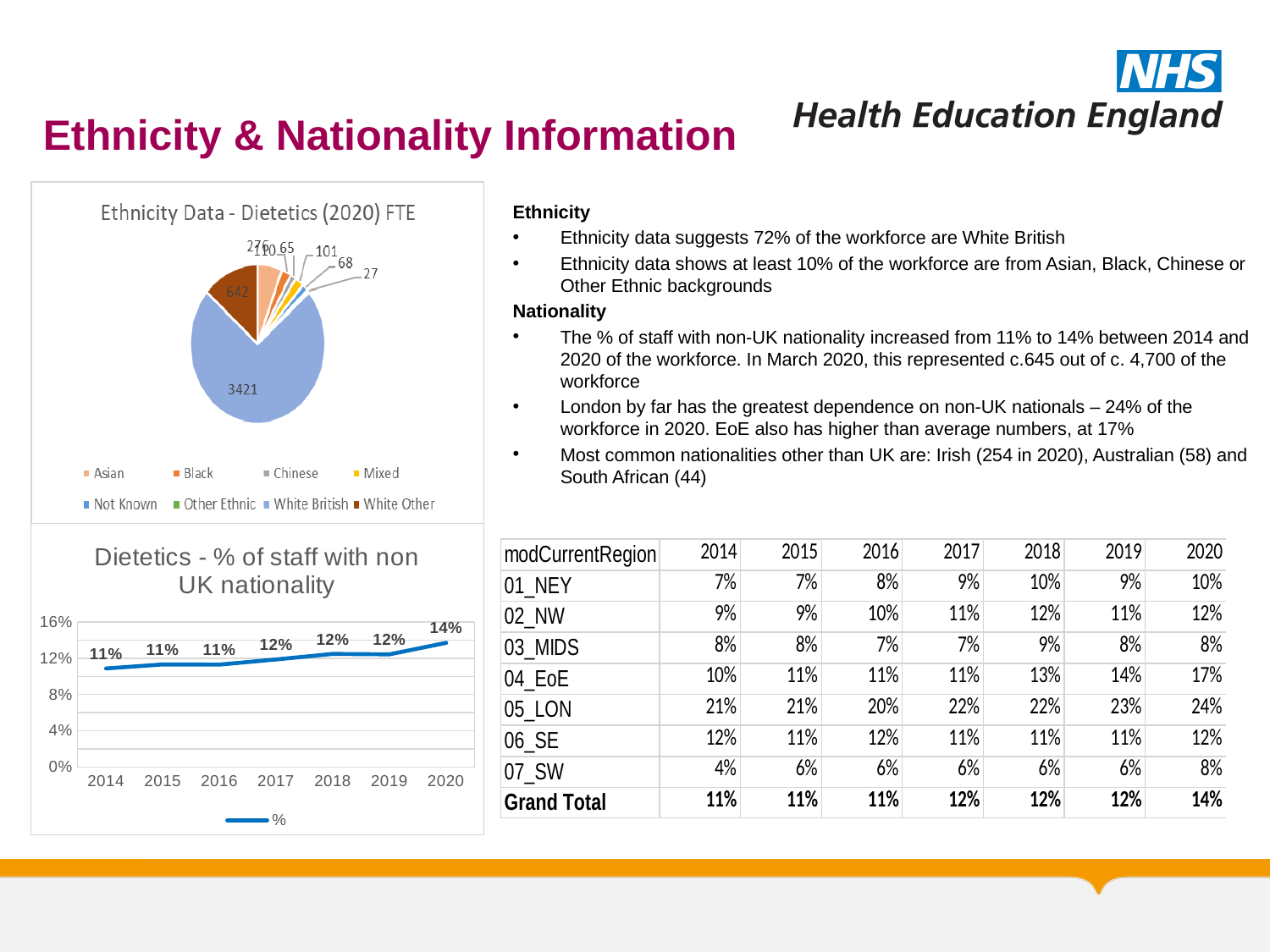
In the pie chart 'Ethnicity Data - Dietetics (2020) FTE', what is the value shown for White Other? 642 In the chart 'Dietetics - % of staff with non UK nationality', what is the value for 2014? 11% What kind of chart is 'Ethnicity Data - Dietetics (2020) FTE'? Pie chart In the chart 'Dietetics - % of staff with non UK nationality', which year has the highest value? 2020 In the chart 'Dietetics - % of staff with non UK nationality', what is the difference between the 2020 value and the 2014 value? 3% In the pie chart 'Ethnicity Data - Dietetics (2020) FTE', what is the value shown for White British? 3421 In the chart 'Dietetics - % of staff with non UK nationality', do the values rise or fall from 2014 to 2020? Rise In the chart 'Dietetics - % of staff with non UK nationality', what is the value for 2020? 14% How many years are plotted in the chart 'Dietetics - % of staff with non UK nationality'? 7 How many categories does the legend of the pie chart 'Ethnicity Data - Dietetics (2020) FTE' list? 8 In the pie chart 'Ethnicity Data - Dietetics (2020) FTE', which category has the largest slice? White British What kind of chart is 'Dietetics - % of staff with non UK nationality'? Line chart